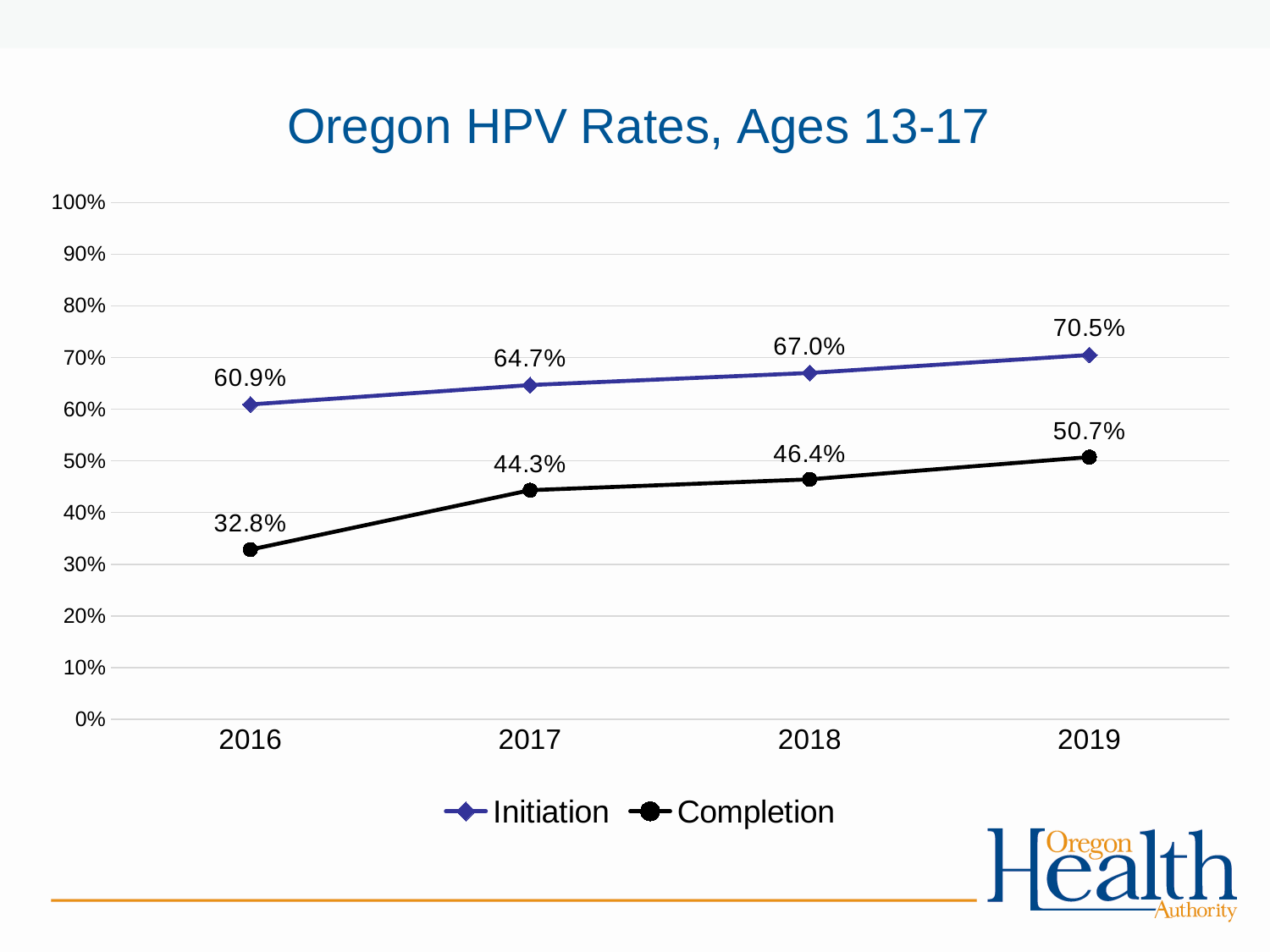
What is the Completion rate in 2018? 46.4% Does the Completion rate rise or fall from 2016 to 2019? Rise What is the Completion rate in 2019? 50.7% What is the Initiation rate in 2016? 60.9% How many series does the legend list? 2 Which is larger in 2018, the Initiation rate or the Completion rate? Initiation By how much did the Completion rate increase from 2016 to 2019? 17.9 percentage points In which year is the Initiation rate highest? 2019 In which year is the Completion rate lowest? 2016 What is the difference between the Initiation and Completion rates in 2017? 20.4 percentage points What kind of chart is shown on the slide? Line chart How many years are shown on the x axis? 4